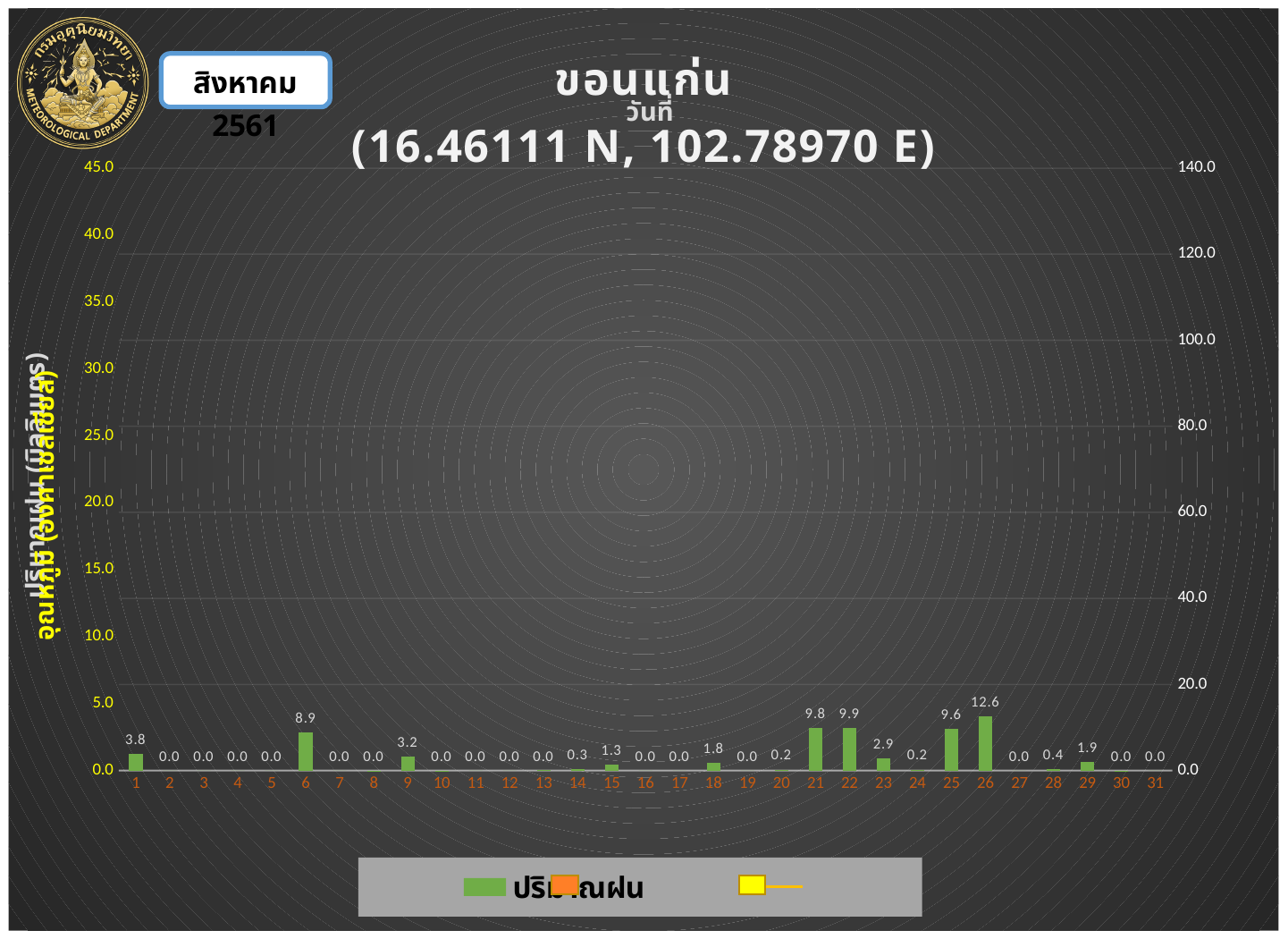
What station name is shown in the chart title? ขอนแก่น How many days are shown on the x axis of the chart? 31 What kind of chart is used to show the daily rainfall values? bar chart Which day has the highest rainfall value? 26 What is the rainfall value shown for day 21? 9.8 Which has a larger rainfall value, day 22 or day 21? day 22 What is the rainfall value shown for day 6? 8.9 Which has a larger rainfall value, day 6 or day 9? day 6 What is the rainfall value shown for day 9? 3.2 What is the difference between the rainfall values for day 26 and day 22? 2.7 What is the rainfall value shown for day 26? 12.6